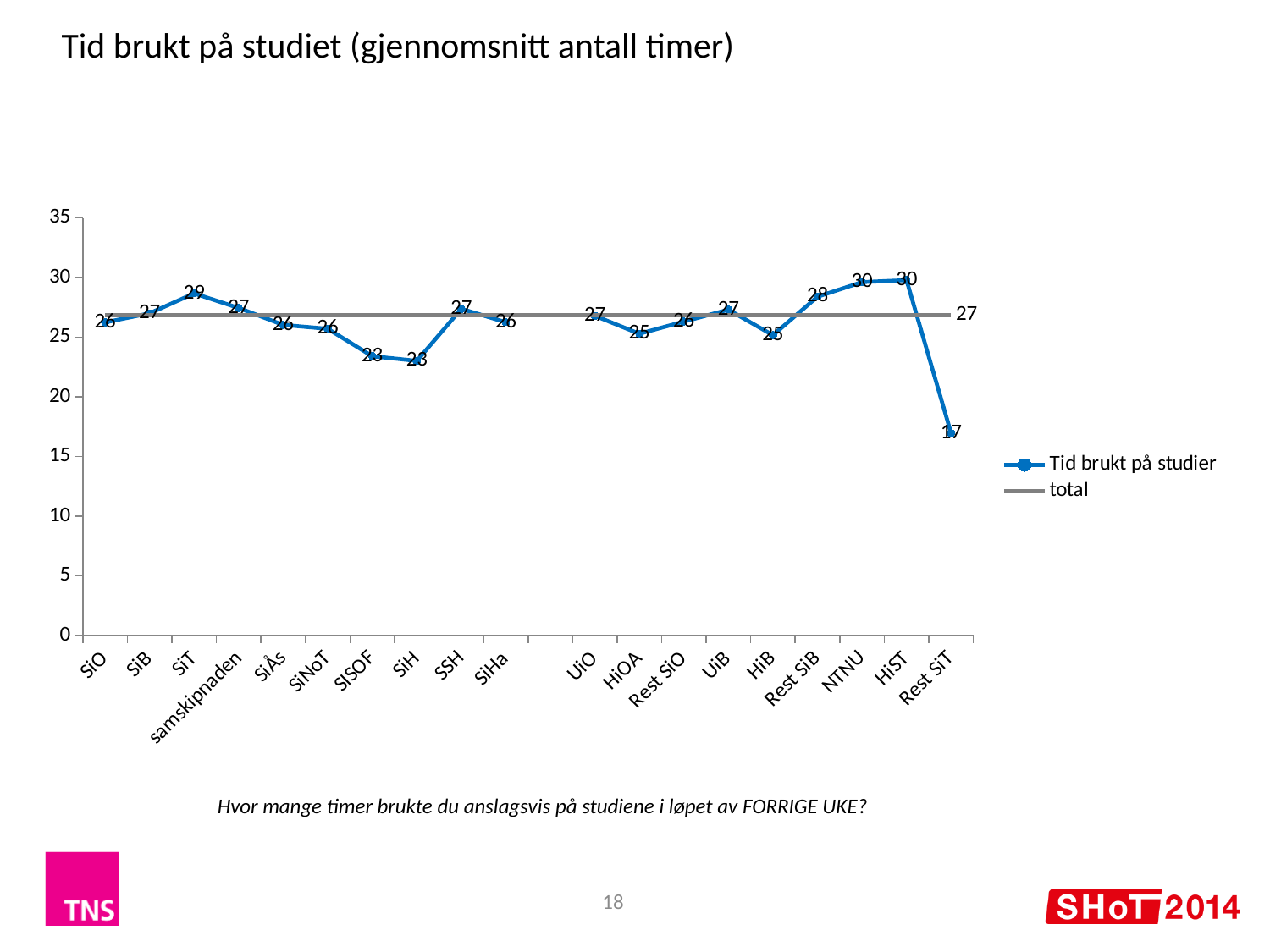
What is the value for SiSOF? 23 What is the difference between the values for HiST and Rest SiT? 13 What is the value for NTNU? 30 What is the value for SiT? 29 What kind of chart is shown on the slide? line chart How many series does the legend list? 2 What is the difference between the values for SiT and SiH? 6 Which is larger, the value for SiT or the value for HiOA? SiT What is the value for Rest SiT? 17 Is the value for Rest SiT greater or less than 20? less What value does the 'total' line show? 27 Which category has the lowest value? Rest SiT